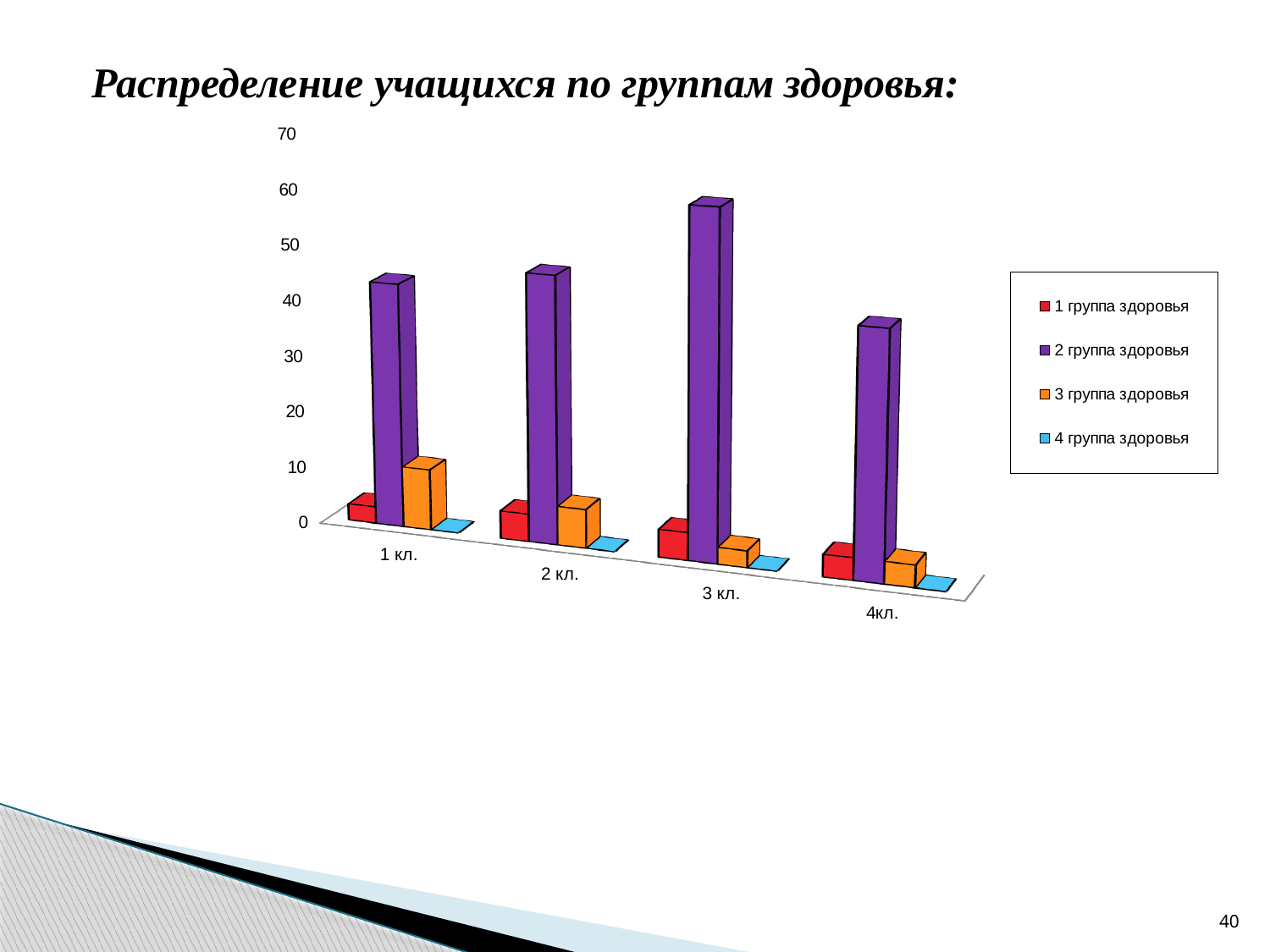
In 1 кл., which is larger: 2 группа здоровья or 3 группа здоровья? 2 группа здоровья For which class is the value of 2 группа здоровья the highest? 3 кл. Is the value of 2 группа здоровья for 3 кл. greater or less than 50? greater Is the value of 2 группа здоровья for 4кл. greater or less than 50? less For 3 группа здоровья, which class has the larger value: 1 кл. or 3 кл.? 1 кл. What kind of chart is shown on the slide? bar chart Is the value of 2 группа здоровья for 1 кл. greater or less than 30? greater How many series does the chart legend list? 4 Which series is shown in purple in the chart legend? 2 группа здоровья How many categories (classes) are shown on the x axis of the chart? 4 What is the title of the chart on the slide? Распределение учащихся по группам здоровья: